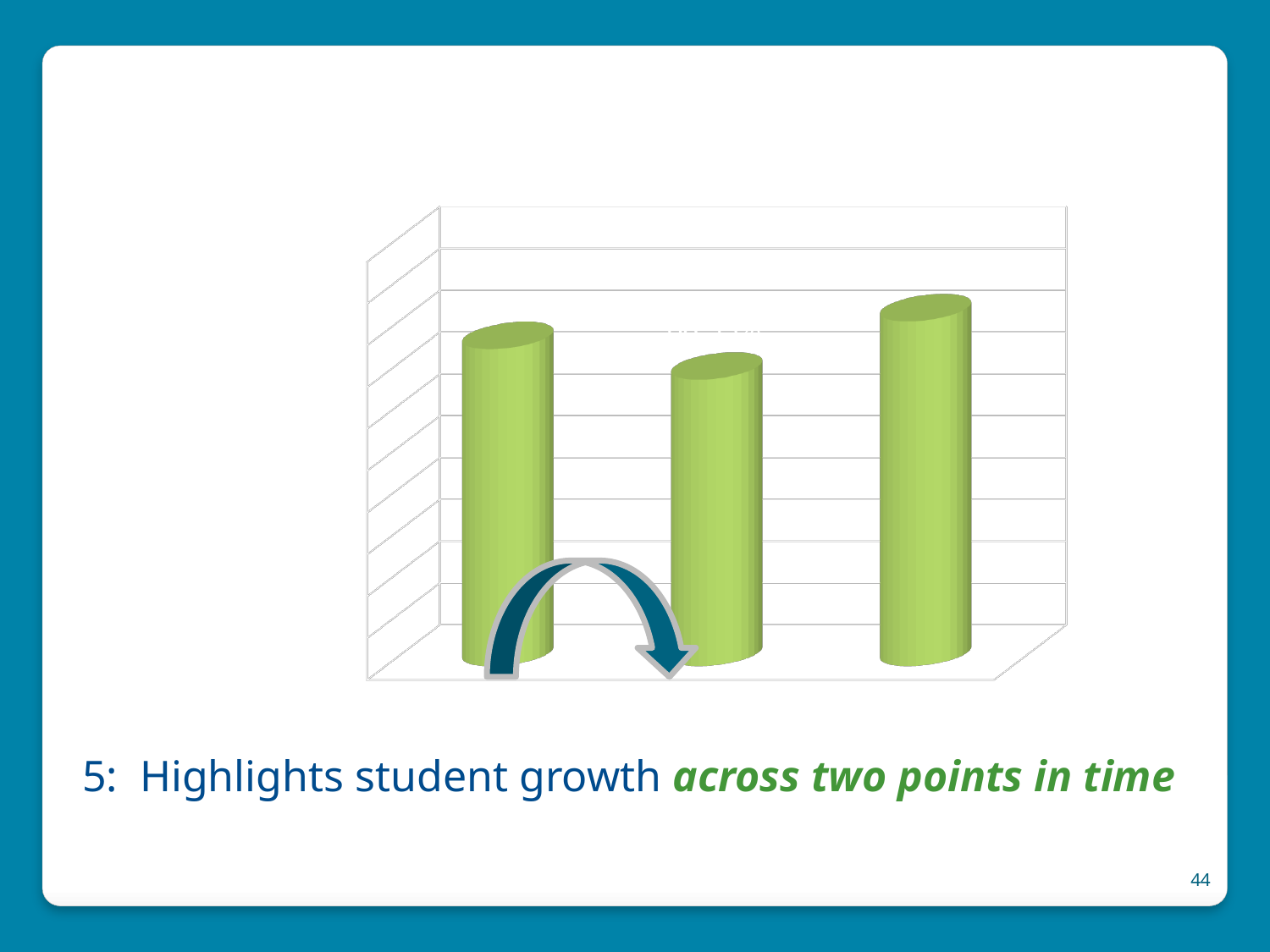
What colour are the bars in the chart? green How many bars does the chart show? 3 Does the value fall or rise from the left bar to the middle bar? fall Which bar is the shortest: the left, middle, or right bar? middle Which is taller, the middle bar or the right bar? right bar Does the value fall or rise from the middle bar to the right bar? rise Which is taller, the left bar or the right bar? right bar Which bar is the tallest: the left, middle, or right bar? right Does the chart display a legend? No Which is taller, the left bar or the middle bar? left bar What kind of chart is shown on the slide? bar chart